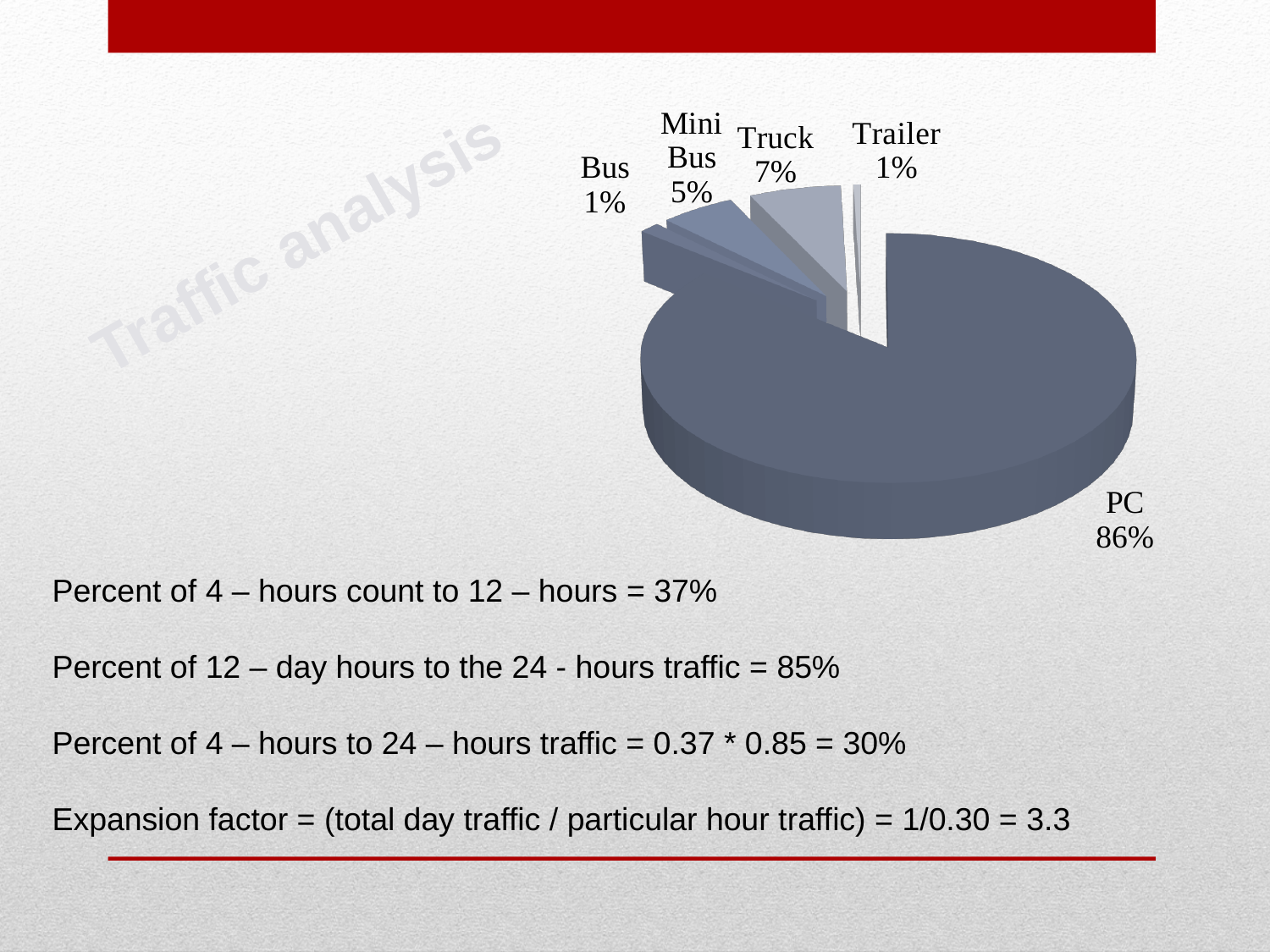
Which is larger, the share for Truck or the share for Mini Bus? Truck Which category's label is placed at the bottom right of the pie? PC What share of the pie does Truck account for? 7% Which category has the largest slice of the pie? PC What share of the pie does Mini Bus account for? 5% How many categories are shown in the pie chart? 5 What is the difference in percentage points between the PC share and the Truck share? 79 What share of the pie does Trailer account for? 1% What is the difference in percentage points between the Truck share and the Mini Bus share? 2 What kind of chart is shown on the slide? Pie chart